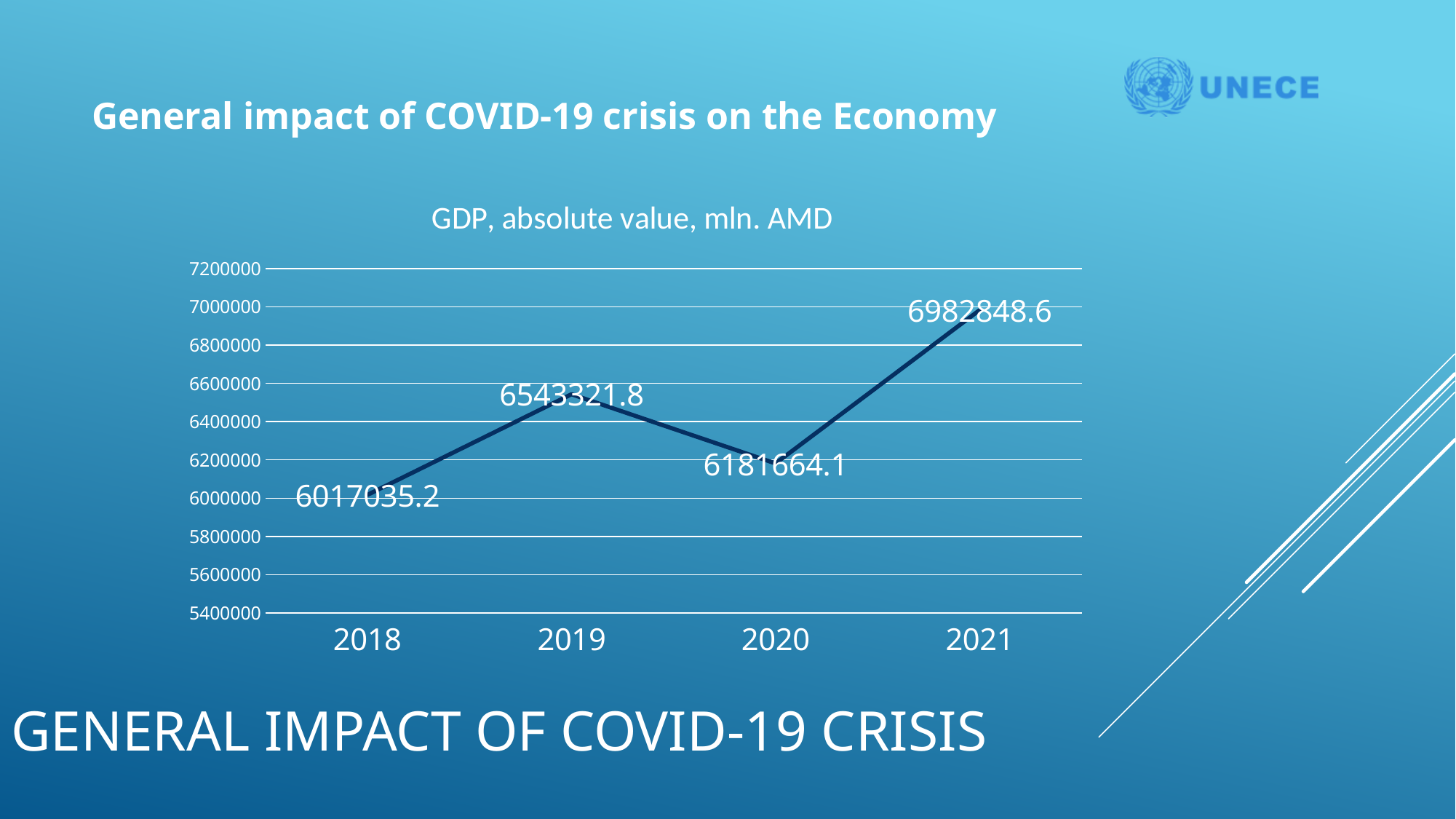
What is the difference between the GDP values for 2021 and 2020? 801184.5 How many years are plotted on the chart? 4 What is the title of the chart? GDP, absolute value, mln. AMD What is the GDP value for 2021? 6982848.6 Which year has a larger GDP value, 2019 or 2020? 2019 What kind of chart is shown on the slide? line chart What is the difference between the GDP values for 2019 and 2018? 526286.6 Is the GDP value for 2019 greater or less than 6400000? greater What is the GDP value for 2020? 6181664.1 Which year has the highest GDP value? 2021 Which year has the lowest GDP value? 2018 What is the GDP value for 2018? 6017035.2